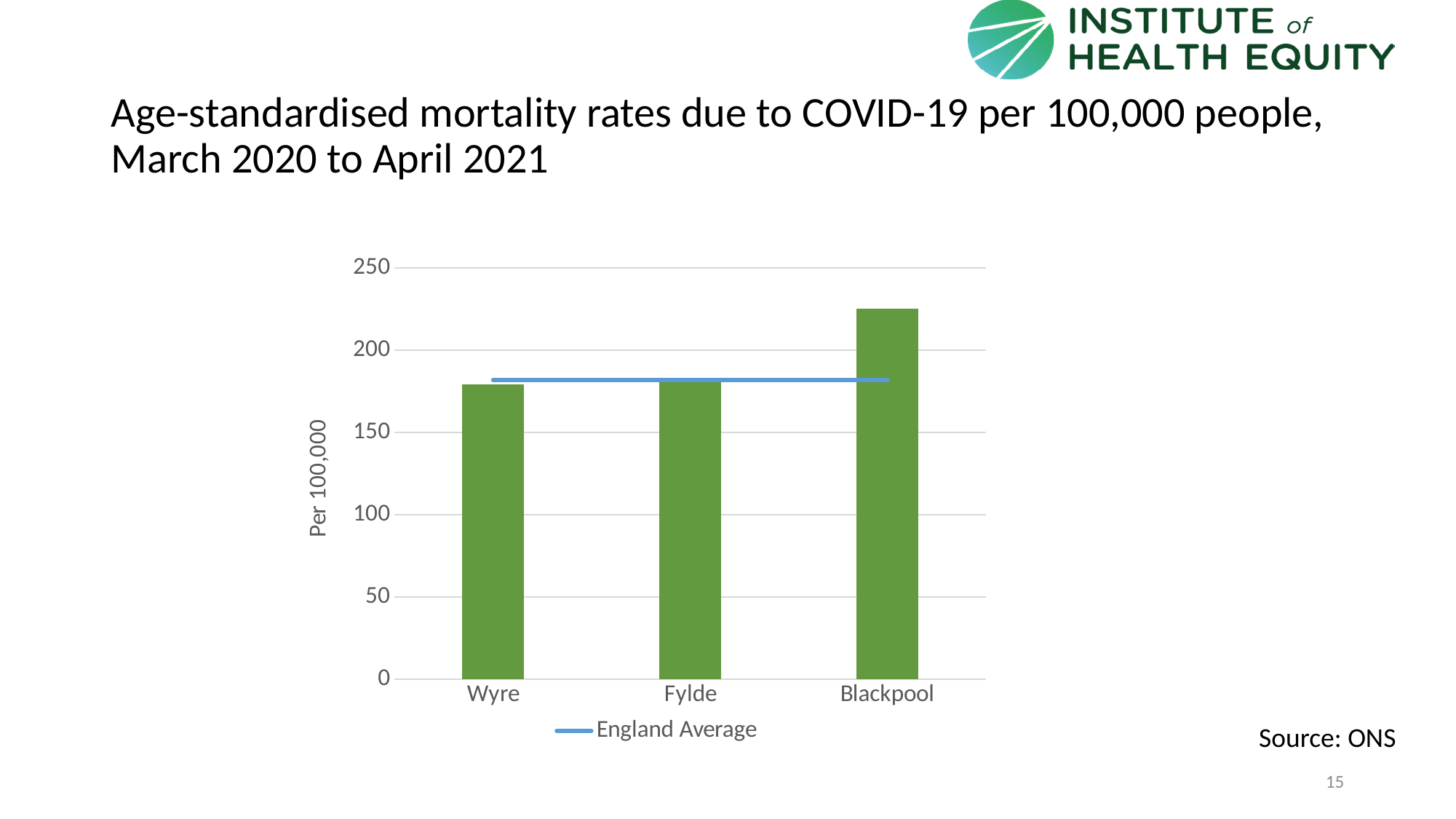
Is the value for Wyre greater or less than 200? less What is the label on the vertical axis of the chart? Per 100,000 Which area has the highest age-standardised COVID-19 mortality rate in the chart? Blackpool Is the value for Wyre greater or less than 150? greater How many areas (categories) are shown on the x axis of the chart? 3 Which is larger, the value for Blackpool or the value for Fylde? Blackpool Which is larger, the value for Wyre or the value for Blackpool? Blackpool Is the value for Fylde greater or less than 150? greater How many entries does the chart's legend list? 1 What kind of chart is shown on the slide? combination bar and line chart